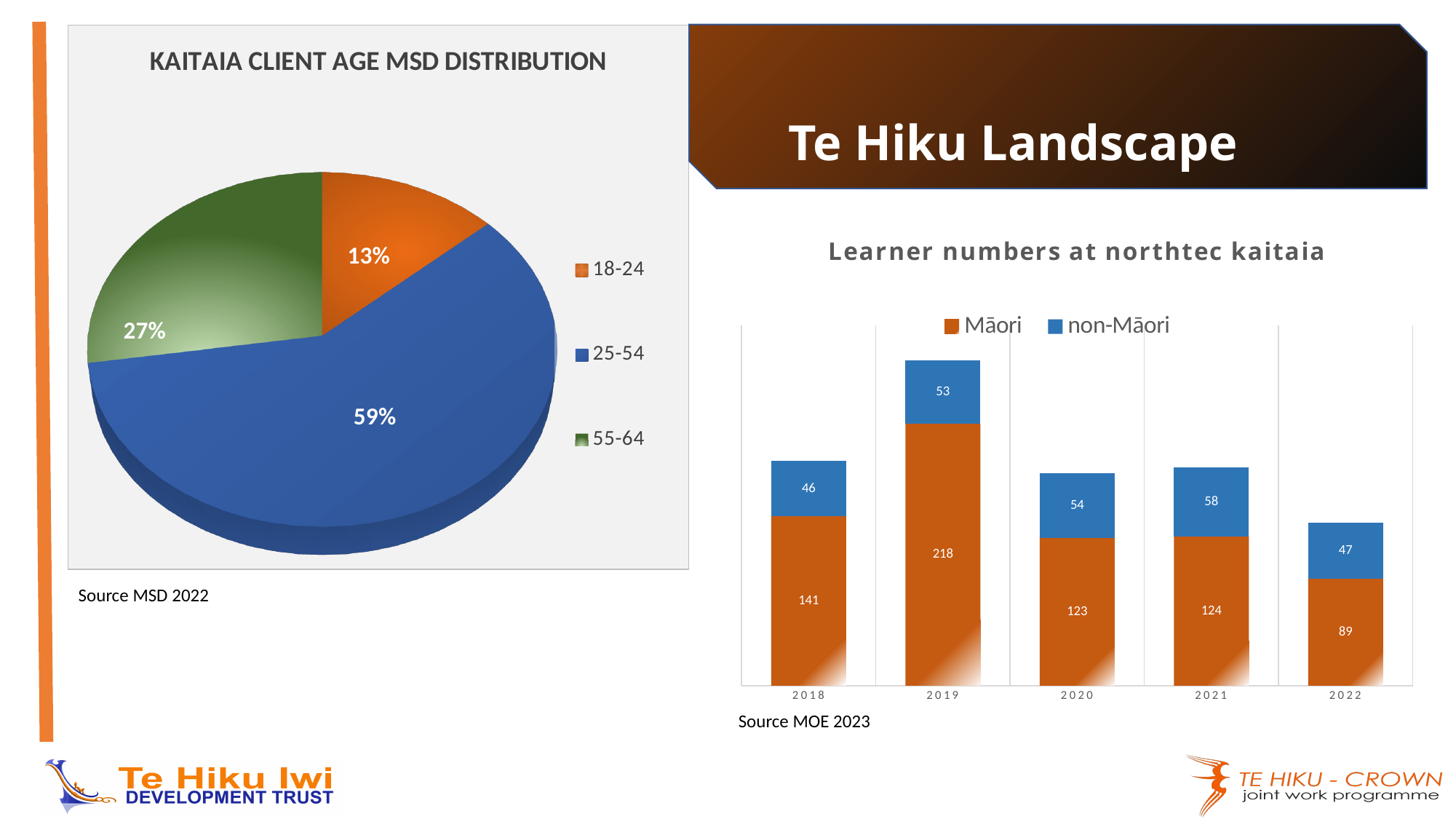
In the 'Learner numbers at northtec kaitaia' chart, how many Māori learners were there in 2019? 218 In the 'KAITAIA CLIENT AGE MSD DISTRIBUTION' chart, how many age groups are shown? 3 In the 'Learner numbers at northtec kaitaia' chart, what is the total number of learners in 2018? 187 In the 'Learner numbers at northtec kaitaia' chart, how many non-Māori learners were there in 2021? 58 In the 'Learner numbers at northtec kaitaia' chart, what kind of chart is shown? Stacked bar chart In the 'KAITAIA CLIENT AGE MSD DISTRIBUTION' chart, what share of clients are aged 25-54? 59% In the 'Learner numbers at northtec kaitaia' chart, how many series does the legend list? 2 In the 'KAITAIA CLIENT AGE MSD DISTRIBUTION' chart, which age group has the smallest share? 18-24 In the 'Learner numbers at northtec kaitaia' chart, what is the difference between Māori learners in 2019 and 2022? 129 In the 'KAITAIA CLIENT AGE MSD DISTRIBUTION' chart, what kind of chart is shown? Pie chart In the 'Learner numbers at northtec kaitaia' chart, which year had the highest number of Māori learners? 2019 In the 'KAITAIA CLIENT AGE MSD DISTRIBUTION' chart, what is the difference in percentage points between the 55-64 and 18-24 shares? 14